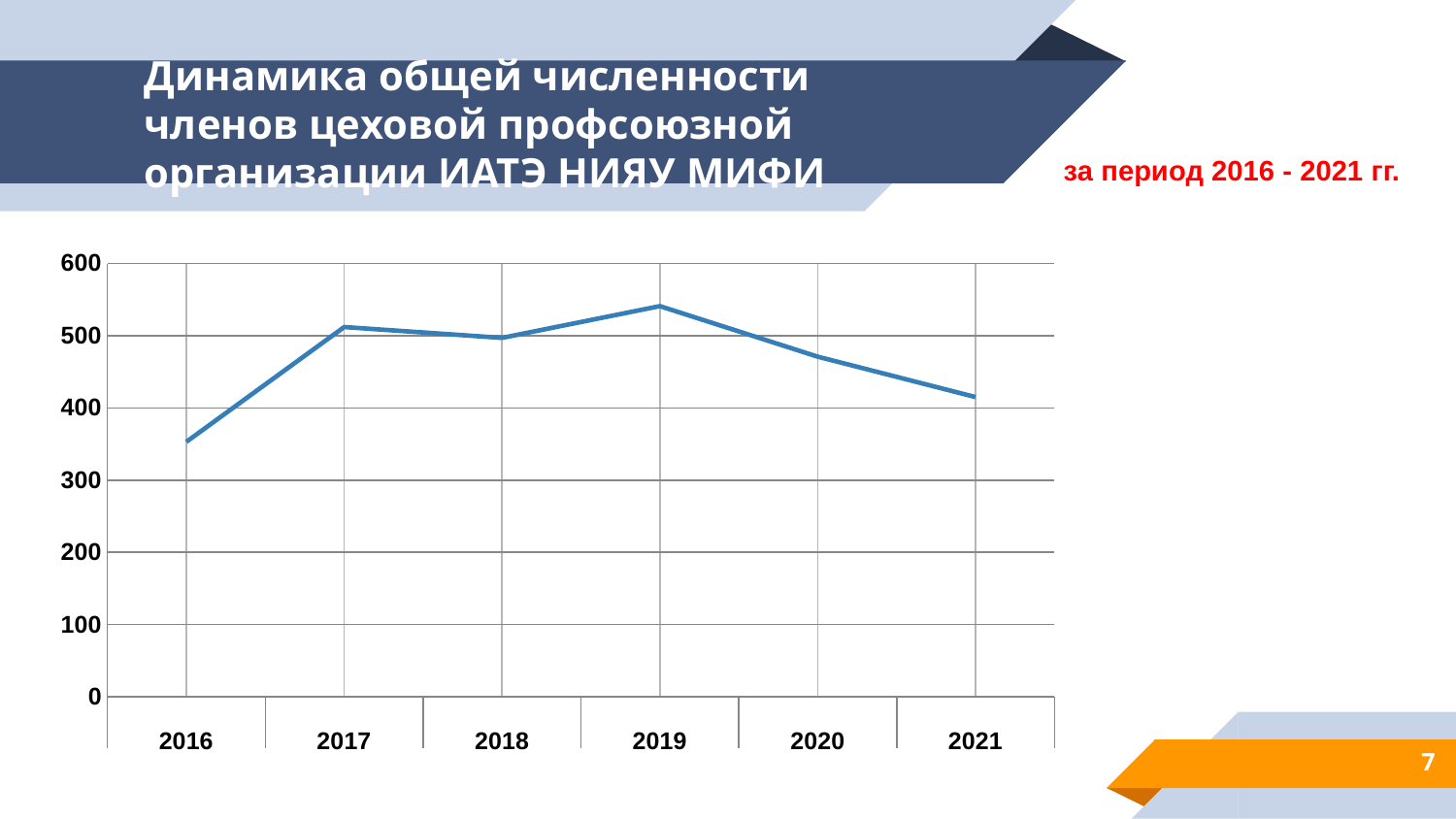
Is the value for 2019 greater or less than 500? greater Which is larger, the value for 2020 or the value for 2021? 2020 What kind of chart is shown on the slide? line chart Which year has the highest value on the chart? 2019 How many years are plotted on the x axis of the chart? 6 Is the value for 2016 greater or less than 400? less What period does the chart cover, according to the red text on the slide? 2016 - 2021 гг. Which is larger, the value for 2016 or the value for 2021? 2021 Do the values rise or fall from 2019 to 2021? fall Which year has the lowest value on the chart? 2016 Is the value for 2021 greater or less than 400? greater